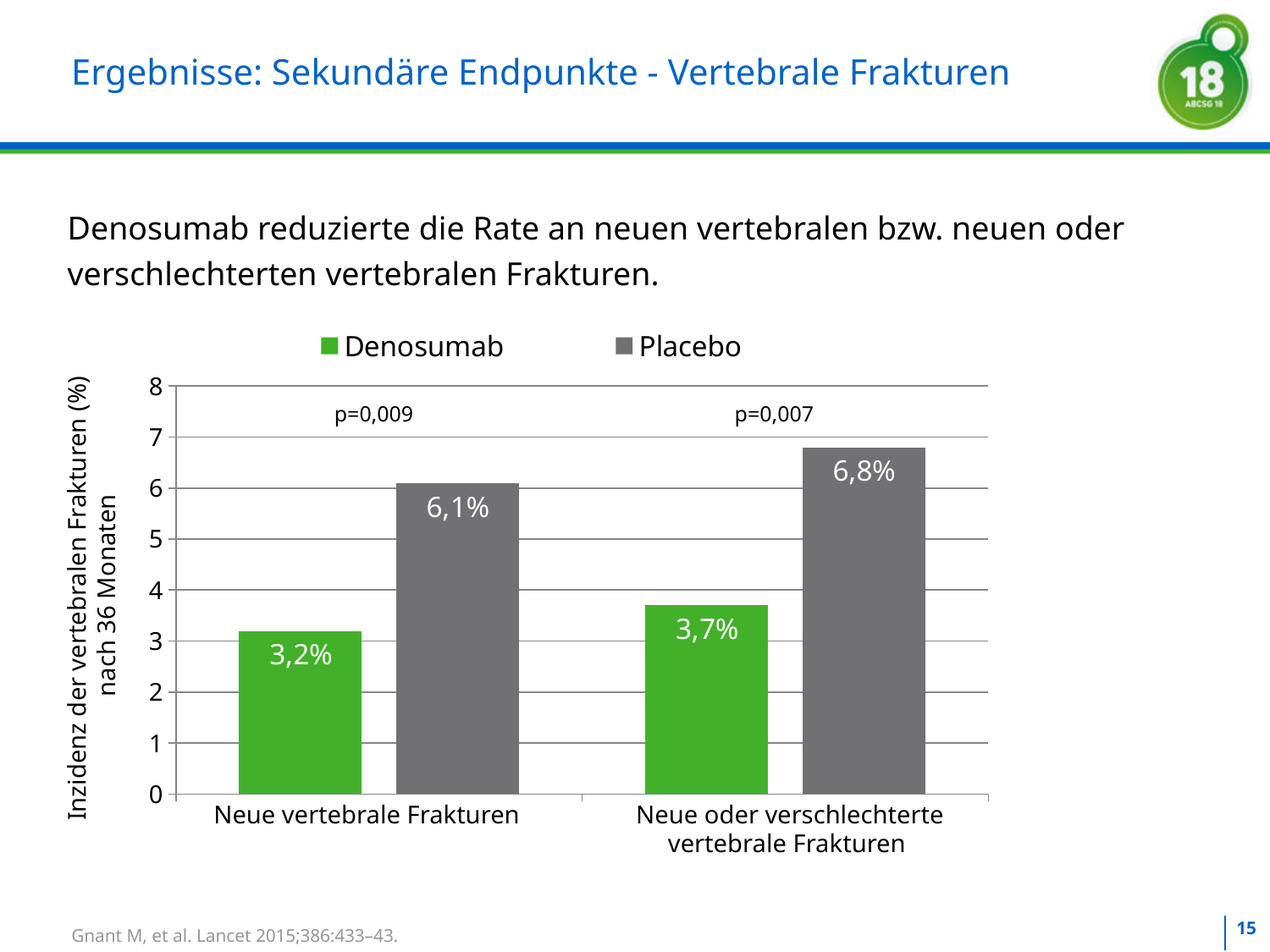
What is the value for Placebo in the 'Neue vertebrale Frakturen' category? 6,1% How many categories are shown on the x axis? 2 What is the difference between the Placebo and Denosumab values for 'Neue vertebrale Frakturen'? 2,9% How many series does the legend list? 2 What is the difference between the Placebo and Denosumab values for 'Neue oder verschlechterte vertebrale Frakturen'? 3,1% What is the value for Placebo in the 'Neue oder verschlechterte vertebrale Frakturen' category? 6,8% What kind of chart is shown on the slide? Bar chart Which is larger for 'Neue oder verschlechterte vertebrale Frakturen': Denosumab or Placebo? Placebo What is the value for Denosumab in the 'Neue vertebrale Frakturen' category? 3,2% What is the value for Denosumab in the 'Neue oder verschlechterte vertebrale Frakturen' category? 3,7% Which bar has the highest value in the chart? Placebo, Neue oder verschlechterte vertebrale Frakturen Which bar has the lowest value in the chart? Denosumab, Neue vertebrale Frakturen